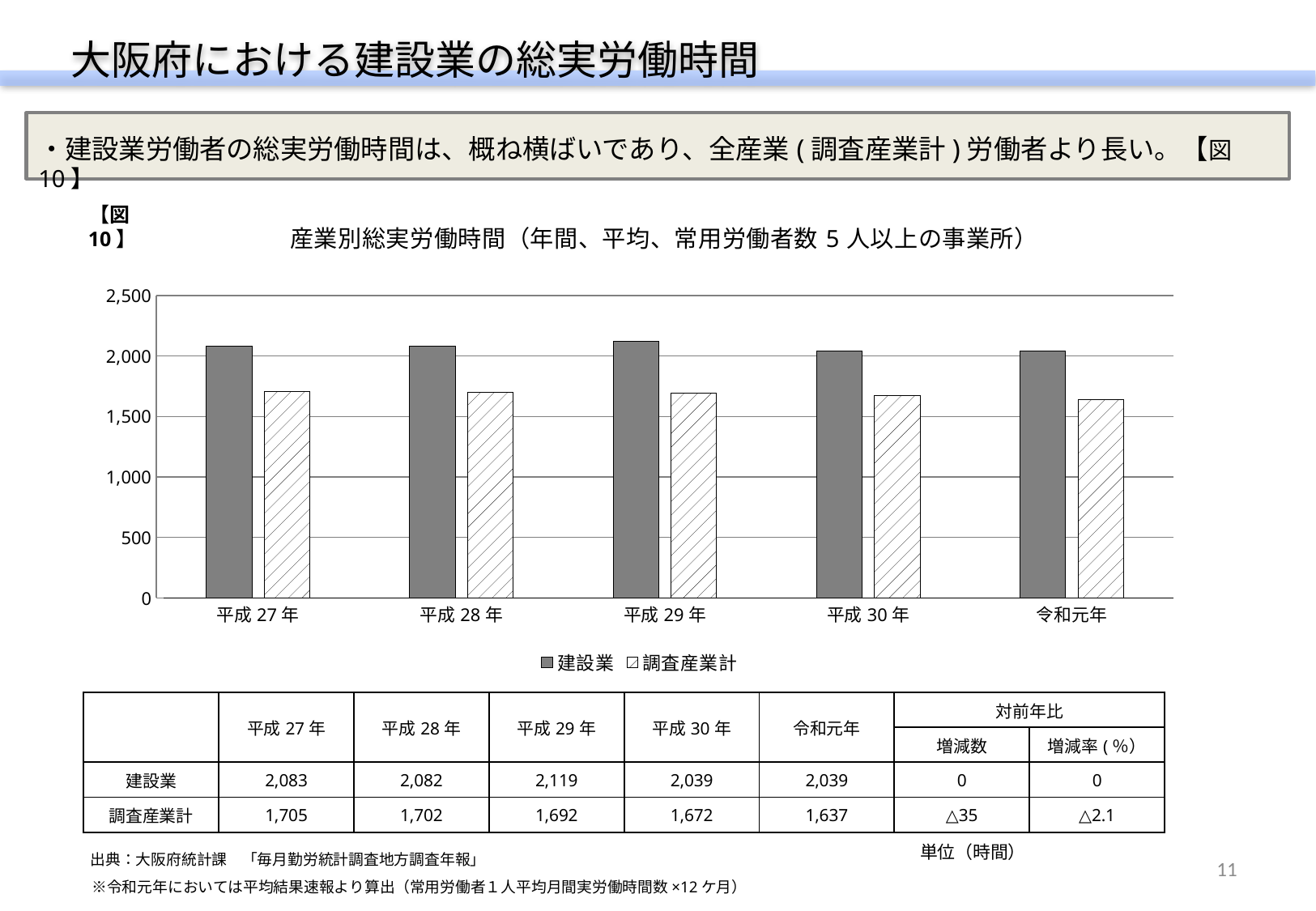
How many series does the legend list? 2 Do the 調査産業計 values rise or fall from 平成27年 to 令和元年? fall Is the value for 建設業 in 平成27年 greater or less than 2,000? greater In which year is the 建設業 value highest? 平成29年 What kind of chart is shown on the slide? bar chart How many years are shown on the x axis of the chart? 5 In which year is the 調査産業計 value lowest? 令和元年 What is the value for 建設業 in 平成29年? 2,119 In 平成30年, which series has the larger value, 建設業 or 調査産業計? 建設業 What is the value for 調査産業計 in 令和元年? 1,637 What is the difference between 建設業 and 調査産業計 in 平成27年? 378 What is the title of the chart? 産業別総実労働時間（年間、平均、常用労働者数5人以上の事業所）